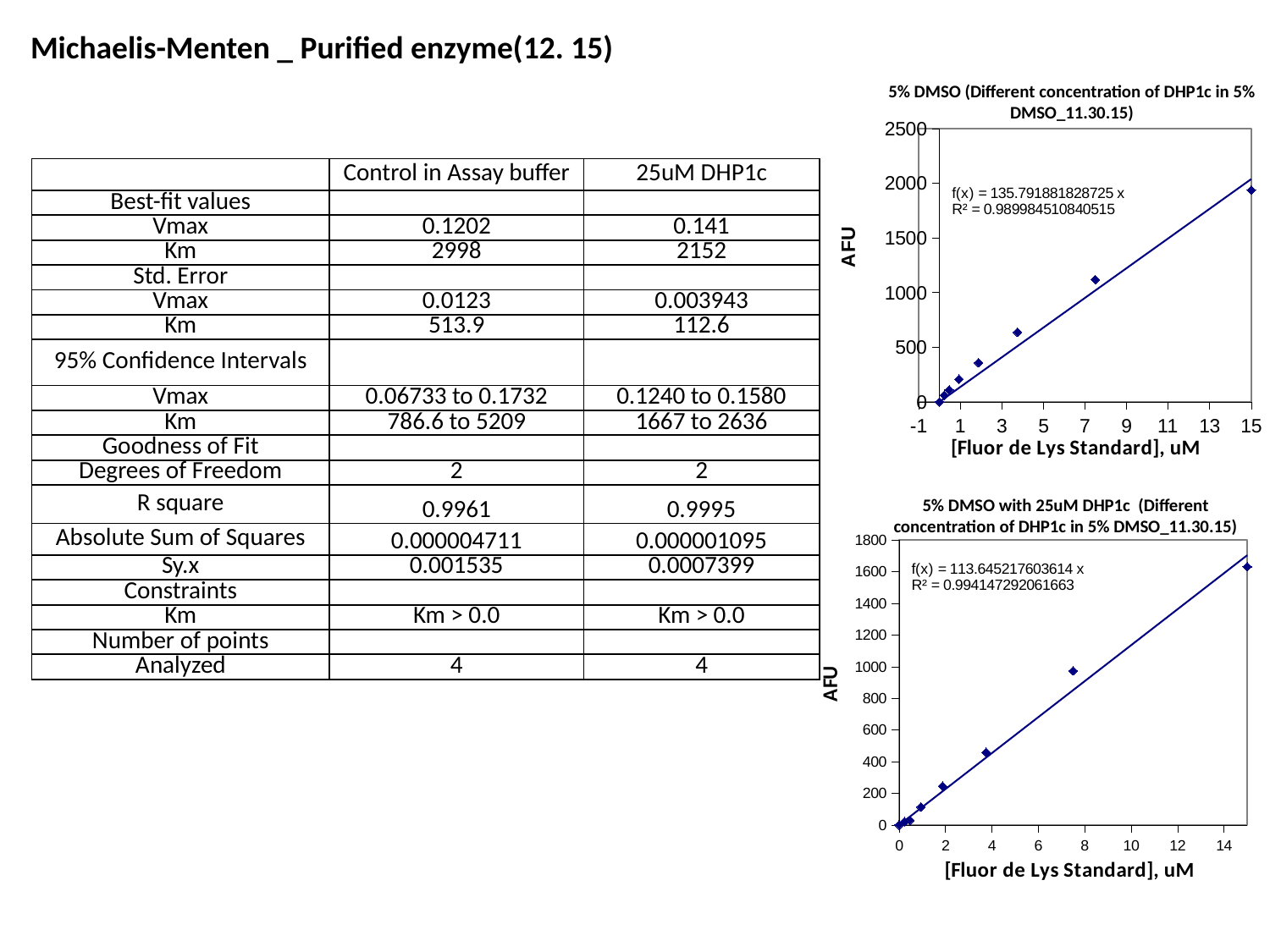
In the top-right chart, is the AFU value of the point near 7.5 uM greater or less than 500? greater What is the y-axis label of the top-right chart? AFU In the bottom-right chart, do the AFU values rise or fall as the Fluor de Lys Standard concentration increases? rise In the top-right chart, at which x value (uM) is the highest AFU point plotted? 15 What kind of chart is the top-right chart titled '5% DMSO (Different concentration of DHP1c in 5% DMSO_11.30.15)'? scatter chart In the bottom-right chart, is the AFU value of the point near 3.7 uM greater or less than 600? less In the bottom-right chart, is the AFU value at 15 uM greater or less than 1400? greater In the top-right chart, do the AFU values rise or fall as the Fluor de Lys Standard concentration increases? rise What R² value is printed on the bottom-right chart? 0.994147292061663 In the bottom-right chart, which point has the larger AFU value: the one at 15 uM or the one near 7.5 uM? the one at 15 uM What kind of chart is the bottom-right chart titled '5% DMSO with 25uM DHP1c'? scatter chart